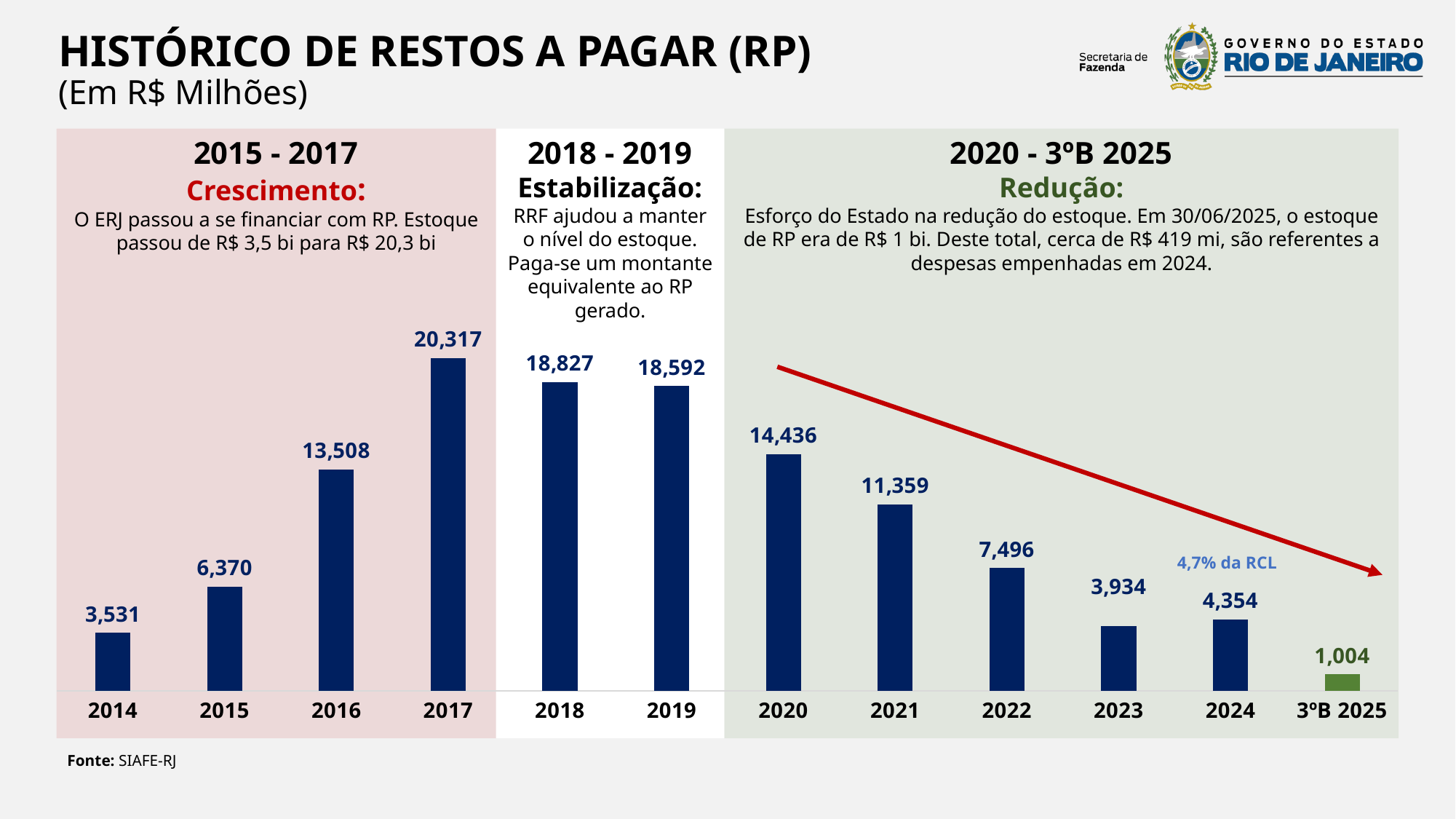
What is the difference between the values for 2024 and 2023? 420 What is the value for 3ºB 2025? 1,004 What is the title of the chart? HISTÓRICO DE RESTOS A PAGAR (RP) Which is larger, the value for 2023 or the value for 2024? 2024 How many bars are plotted in the chart? 12 What kind of chart is shown on the slide? bar chart What is the value for 2017? 20,317 What is the difference between the values for 2018 and 2019? 235 Do the values rise or fall from 2020 to 2023? fall What is the value for 2020? 14,436 Which category has the lowest value? 3ºB 2025 Which year has the highest value? 2017